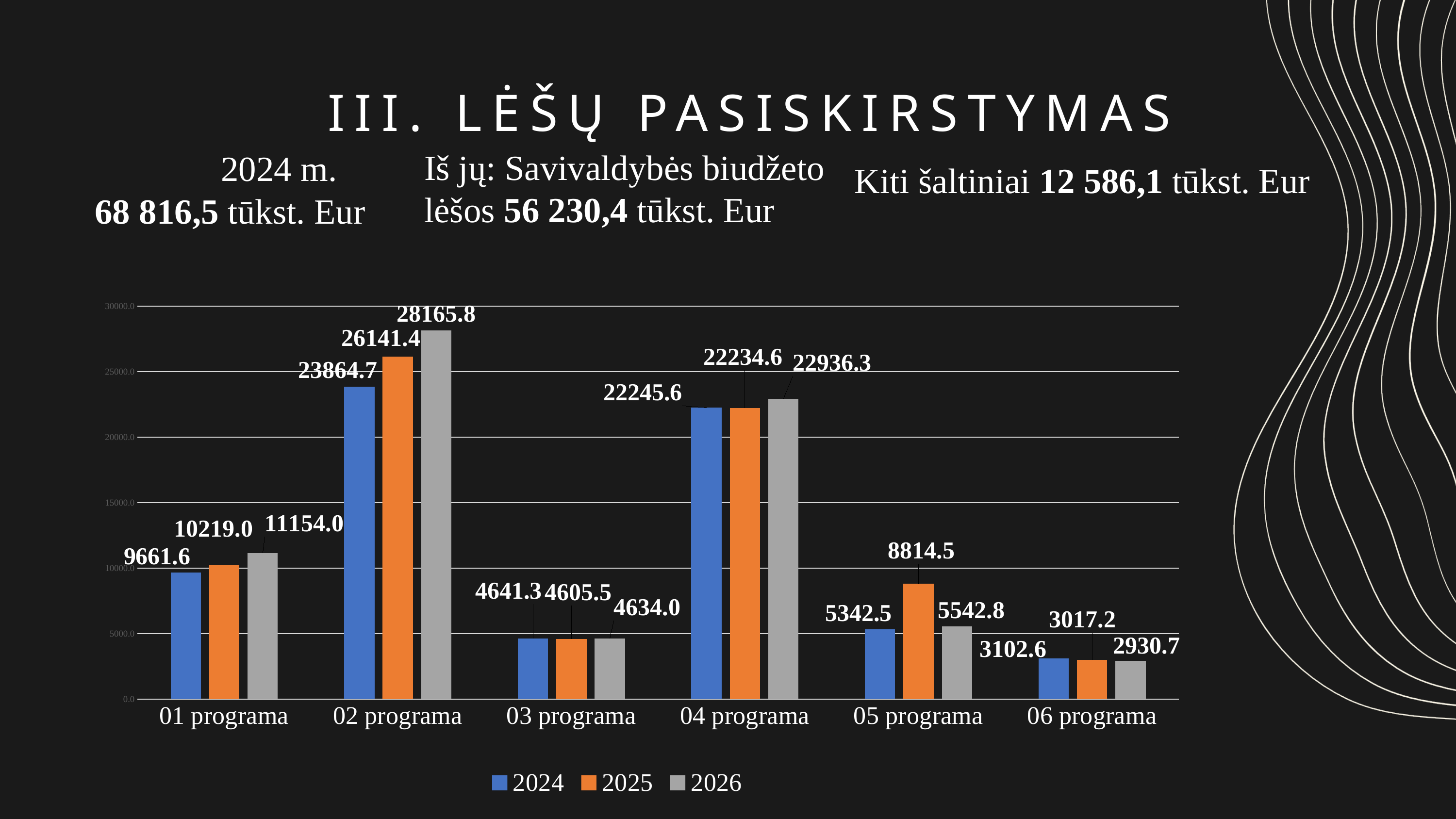
Which category has the highest value in the 2024 series? 02 programa What is the value for 01 programa in the 2024 series? 9661.6 How many categories are shown on the x axis? 6 What kind of chart is shown on the slide? bar chart What is the difference between the 2026 and 2024 values for 02 programa? 4301.1 What is the value for 05 programa in the 2025 series? 8814.5 Do the values for 06 programa rise or fall from 2024 to 2026? fall What is the value for 02 programa in the 2026 series? 28165.8 What is the difference between the 2025 and 2024 values for 05 programa? 3472.0 How many series does the legend list? 3 Which category has the lowest value in the 2026 series? 06 programa Which is larger for 01 programa: the 2025 value or the 2026 value? 2026